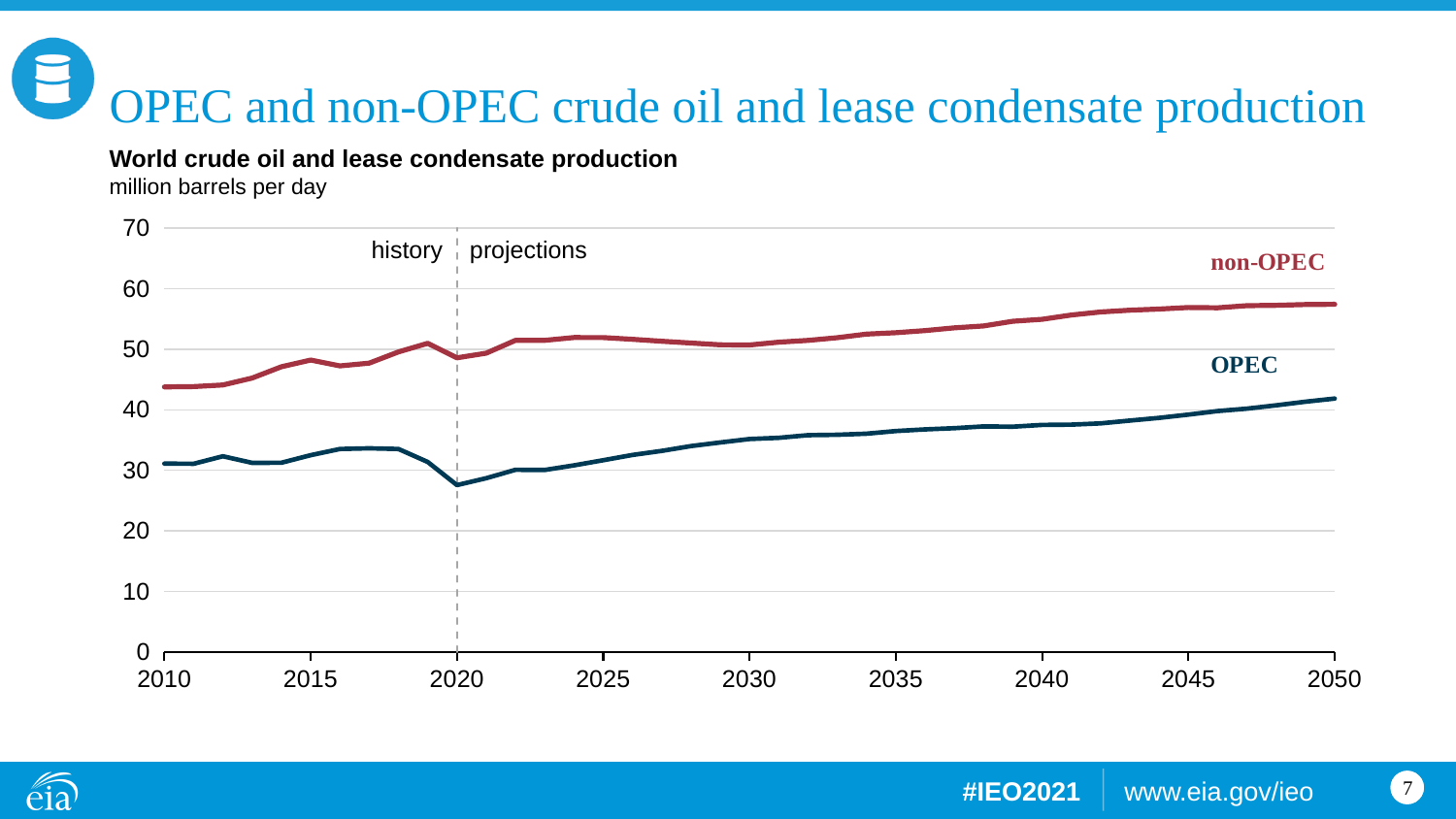
Is the OPEC value in 2020 greater or less than 30? less What unit is the chart measured in? million barrels per day In which year does the dashed line separate history from projections? 2020 What kind of chart is shown on the slide? line chart Is the OPEC value in 2030 greater or less than 40? less Which series is drawn in red? non-OPEC How many series are plotted on the chart? 2 Is the OPEC value in 2050 greater or less than 40? greater Does OPEC production rise or fall between 2020 and 2050? rise Which series has the higher production in 2050, OPEC or non-OPEC? non-OPEC